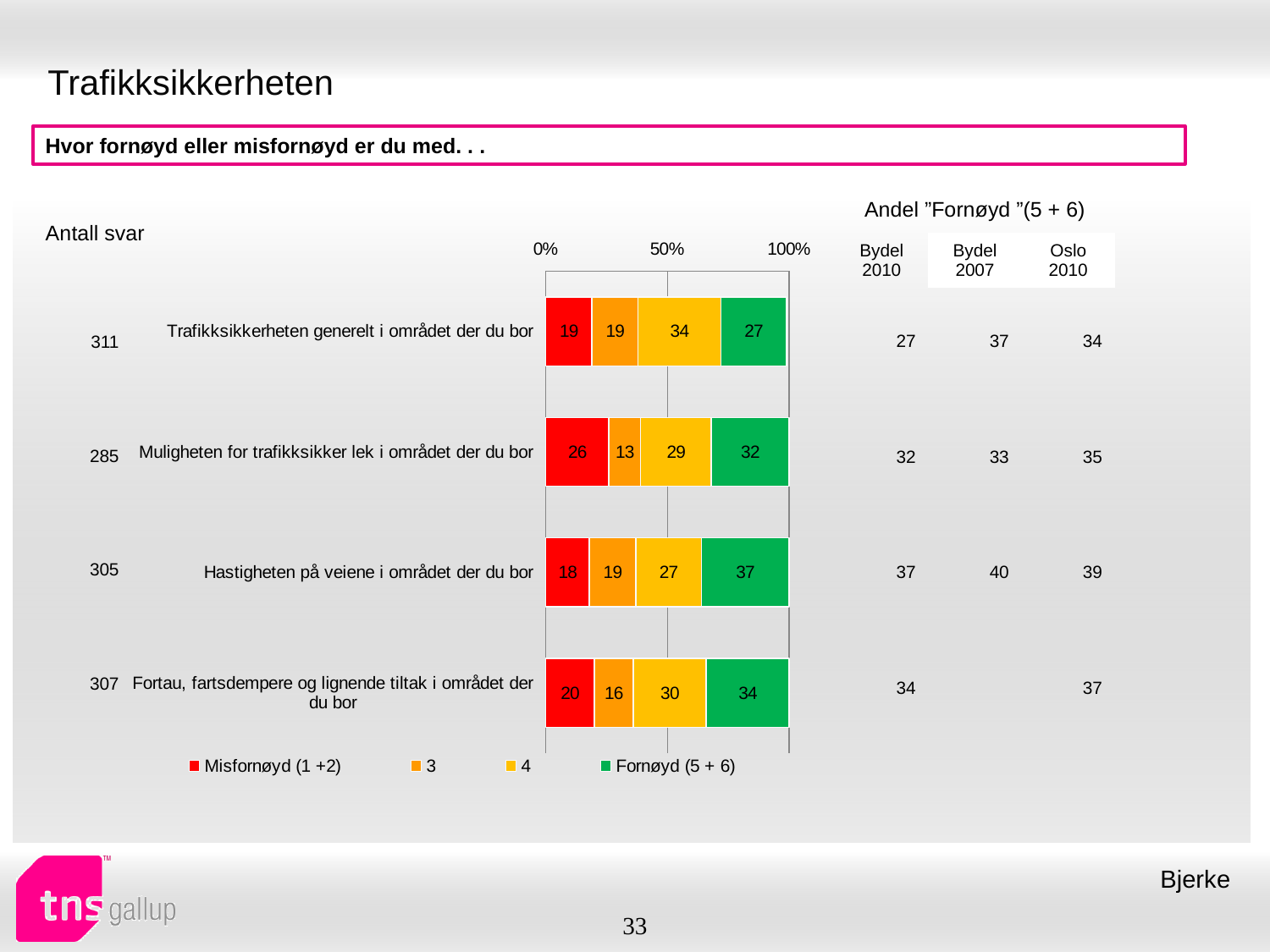
Which is larger: the Fornøyd (5 + 6) value for "Fortau, fartsdempere og lignende tiltak i området der du bor" or for "Trafikksikkerheten generelt i området der du bor"? Fortau, fartsdempere og lignende tiltak i området der du bor What colour represents the Fornøyd (5 + 6) series in the chart? green What is the difference between the Misfornøyd (1 +2) values for "Muligheten for trafikksikker lek i området der du bor" and "Hastigheten på veiene i området der du bor"? 8 How many categories are plotted in the chart? 4 What is the total of the stacked bar for "Muligheten for trafikksikker lek i området der du bor"? 100 What kind of chart is shown on the slide? stacked bar chart What is the Misfornøyd (1 +2) value for "Muligheten for trafikksikker lek i området der du bor"? 26 Which category has the highest Fornøyd (5 + 6) value? Hastigheten på veiene i området der du bor What is the value of series "4" for "Trafikksikkerheten generelt i området der du bor"? 34 Which category has the lowest value for series "3"? Muligheten for trafikksikker lek i området der du bor What is the Fornøyd (5 + 6) value for "Hastigheten på veiene i området der du bor"? 37 How many series does the legend list? 4